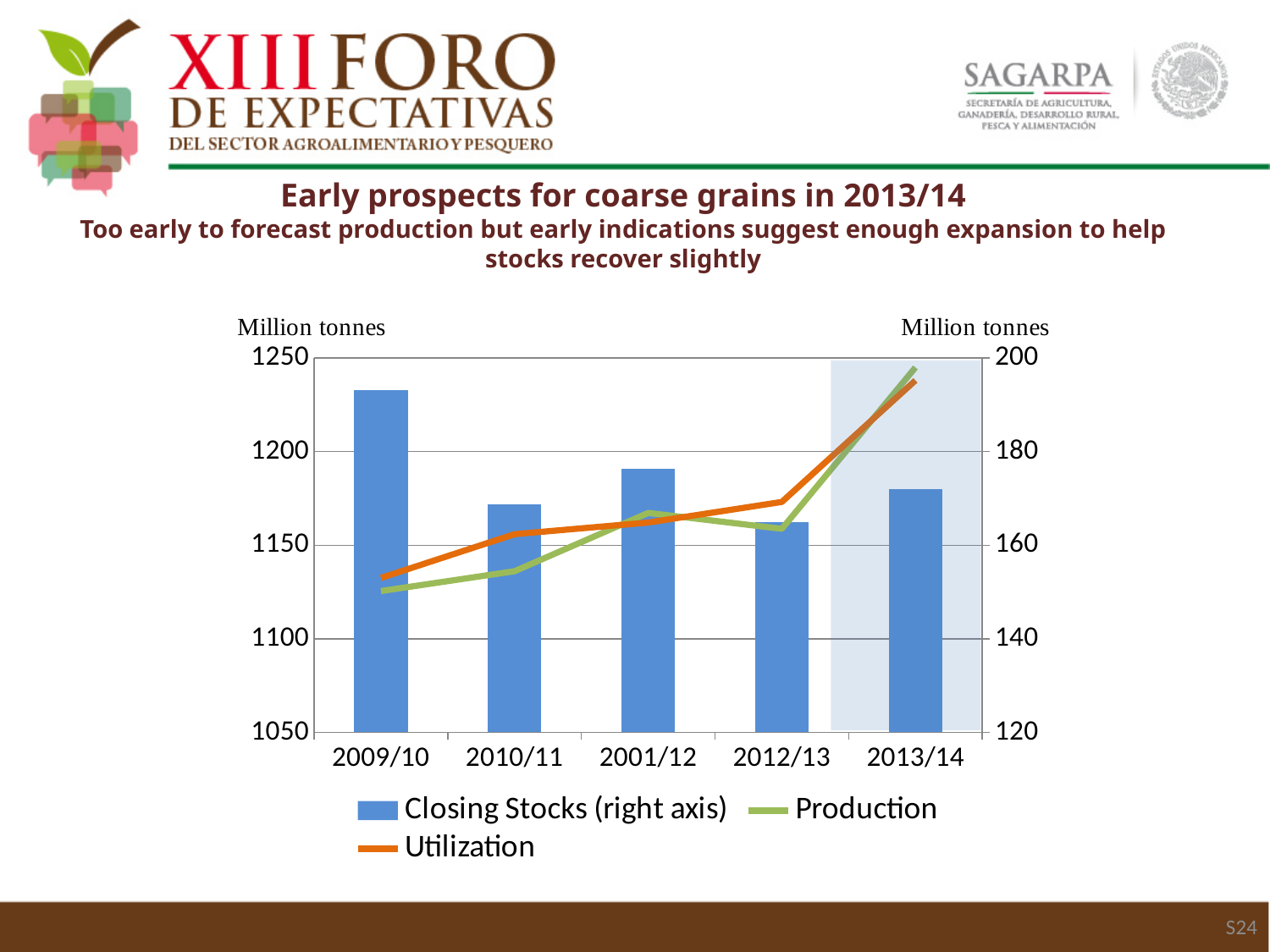
Does the Utilization line rise or fall from 2009/10 to 2013/14? Rises Is the Closing Stocks value for 2012/13 greater or less than 180 on the right axis? less How many years are shown on the x axis of the chart? 5 Is the Production value for 2013/14 greater or less than 1200 on the left axis? greater Which year has the highest Closing Stocks bar? 2009/10 Which year has the lowest Closing Stocks bar? 2012/13 How many series does the chart legend list? 3 Which year has the larger Closing Stocks bar, 2009/10 or 2013/14? 2009/10 Is the Utilization value for 2009/10 greater or less than 1150 on the left axis? less What kind of chart is shown on the slide? Combined bar and line chart Which series is plotted against the right axis according to the legend? Closing Stocks